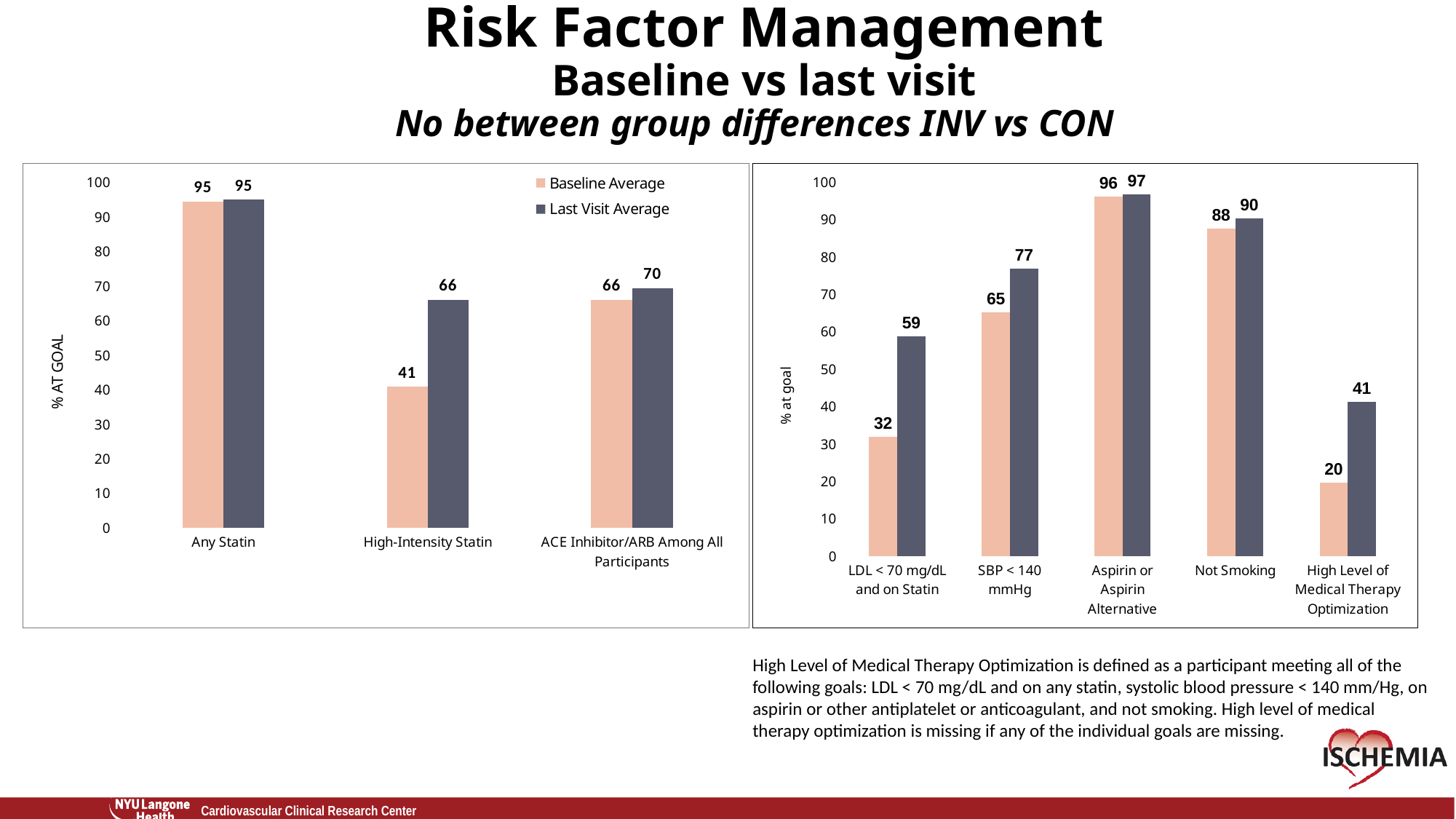
In the left chart, what is the Last Visit Average value for ACE Inhibitor/ARB Among All Participants? 70 In the right chart, which category has the highest Last Visit Average value? Aspirin or Aspirin Alternative In the left chart, what is the Baseline Average value for High-Intensity Statin? 41 In the right chart, what is the Last Visit Average value for SBP < 140 mmHg? 77 What type of chart is the left chart? Bar chart In the right chart, which is larger: the Baseline Average for Not Smoking or the Baseline Average for SBP < 140 mmHg? Not Smoking How many series does the legend on the left chart list? 2 In the right chart, what is the Baseline Average value for LDL < 70 mg/dL and on Statin? 32 How many categories are shown on the x axis of the right chart? 5 In the right chart, which category has the lowest Baseline Average value? High Level of Medical Therapy Optimization In the right chart, what is the difference between the Last Visit Average and Baseline Average for High Level of Medical Therapy Optimization? 21 In the left chart, what is the difference between the Last Visit Average and Baseline Average for High-Intensity Statin? 25